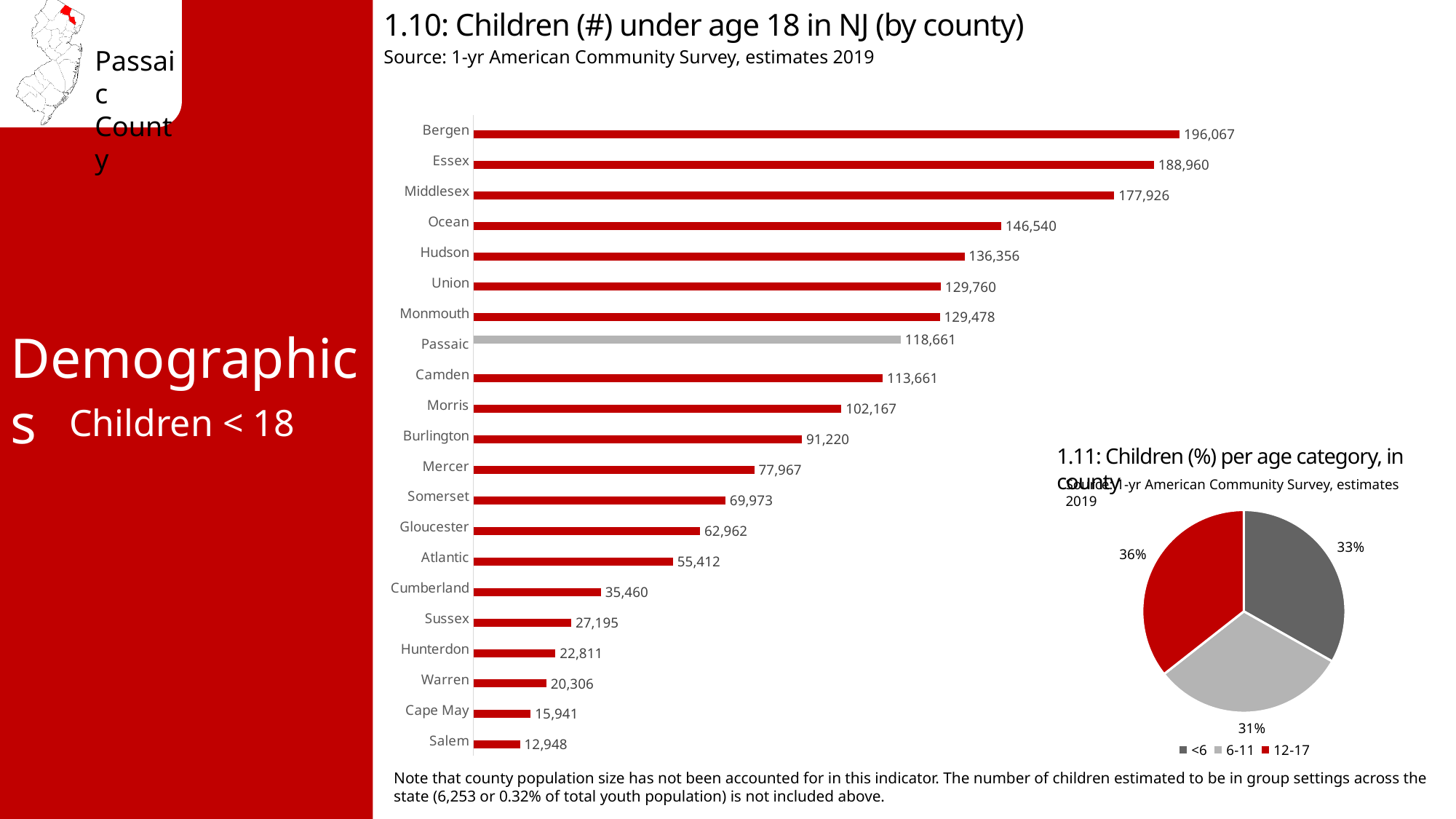
In the chart '1.10: Children (#) under age 18 in NJ (by county)', what is the value for Passaic? 118,661 In the chart '1.10: Children (#) under age 18 in NJ (by county)', what is the difference between the values for Bergen and Essex? 7,107 What kind of chart is '1.10: Children (#) under age 18 in NJ (by county)'? Bar chart In the chart '1.10: Children (#) under age 18 in NJ (by county)', which county has the lowest value? Salem In the chart '1.10: Children (#) under age 18 in NJ (by county)', which county has the highest value? Bergen In the chart '1.10: Children (#) under age 18 in NJ (by county)', how many counties are shown? 21 In the chart '1.10: Children (#) under age 18 in NJ (by county)', which has a larger value, Ocean or Hudson? Ocean In the pie chart '1.11: Children (%) per age category, in county', how many age categories does the legend list? 3 In the pie chart '1.11: Children (%) per age category, in county', which age category has the smallest share? 6-11 In the pie chart '1.11: Children (%) per age category, in county', what share is the 12-17 age category? 36% In the chart '1.10: Children (#) under age 18 in NJ (by county)', which bar is coloured grey instead of red? Passaic In the chart '1.10: Children (#) under age 18 in NJ (by county)', what is the value for Cape May? 15,941